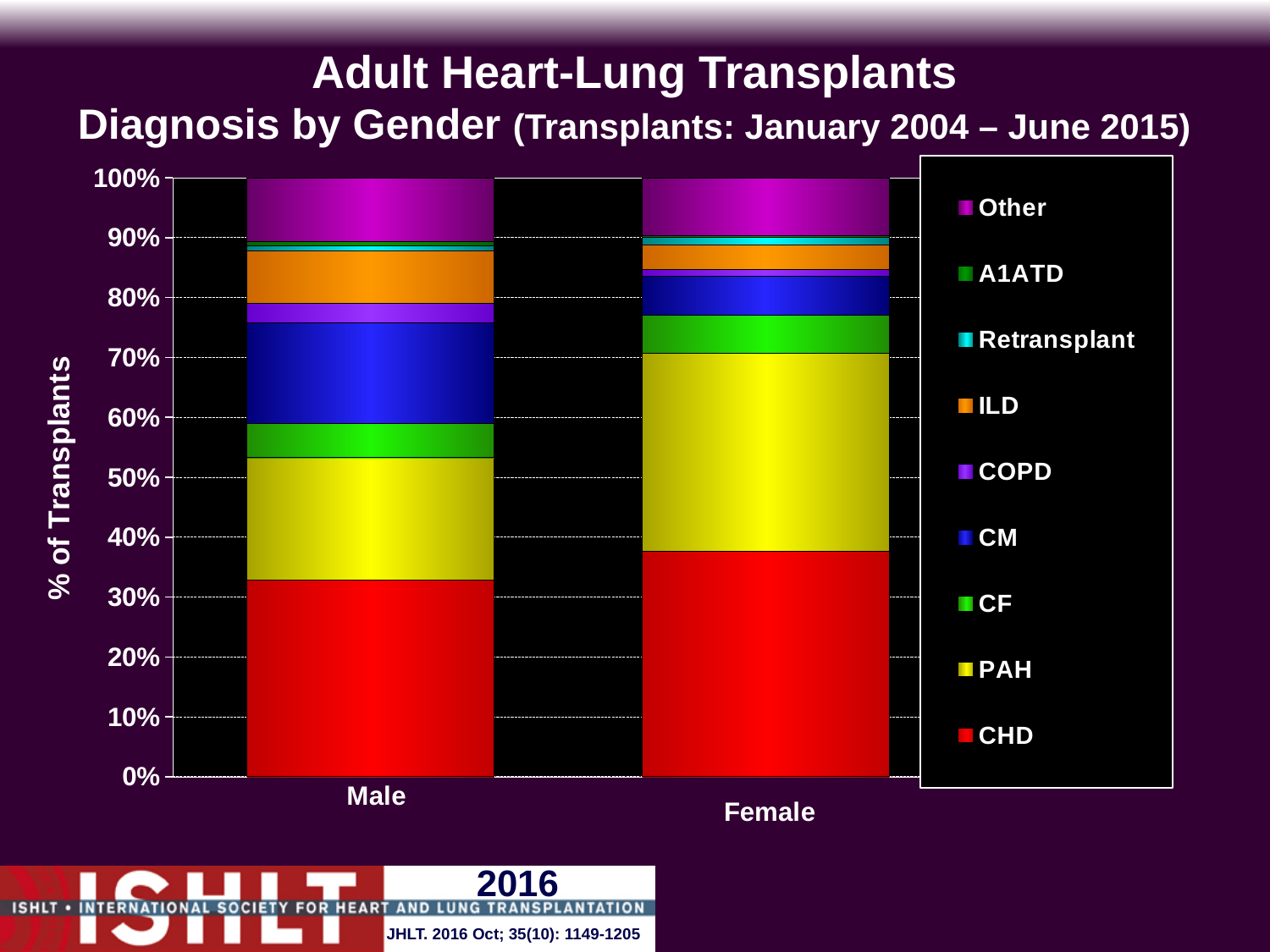
Which diagnosis is the largest segment of the Female bar? CHD Which gender has the larger PAH share, Male or Female? Female How many gender categories are plotted on the x axis? 2 Is the CHD share for Female greater or less than 40%? less Which diagnosis is the largest segment of the Male bar? CHD Is the CM share for Female greater or less than 10%? less Which gender has the larger CM share, Male or Female? Male Is the PAH share for Female greater or less than 20%? greater What is the total height of the Male stacked bar? 100% What kind of chart is shown on the slide? Stacked bar chart How many diagnosis series does the legend list? 9